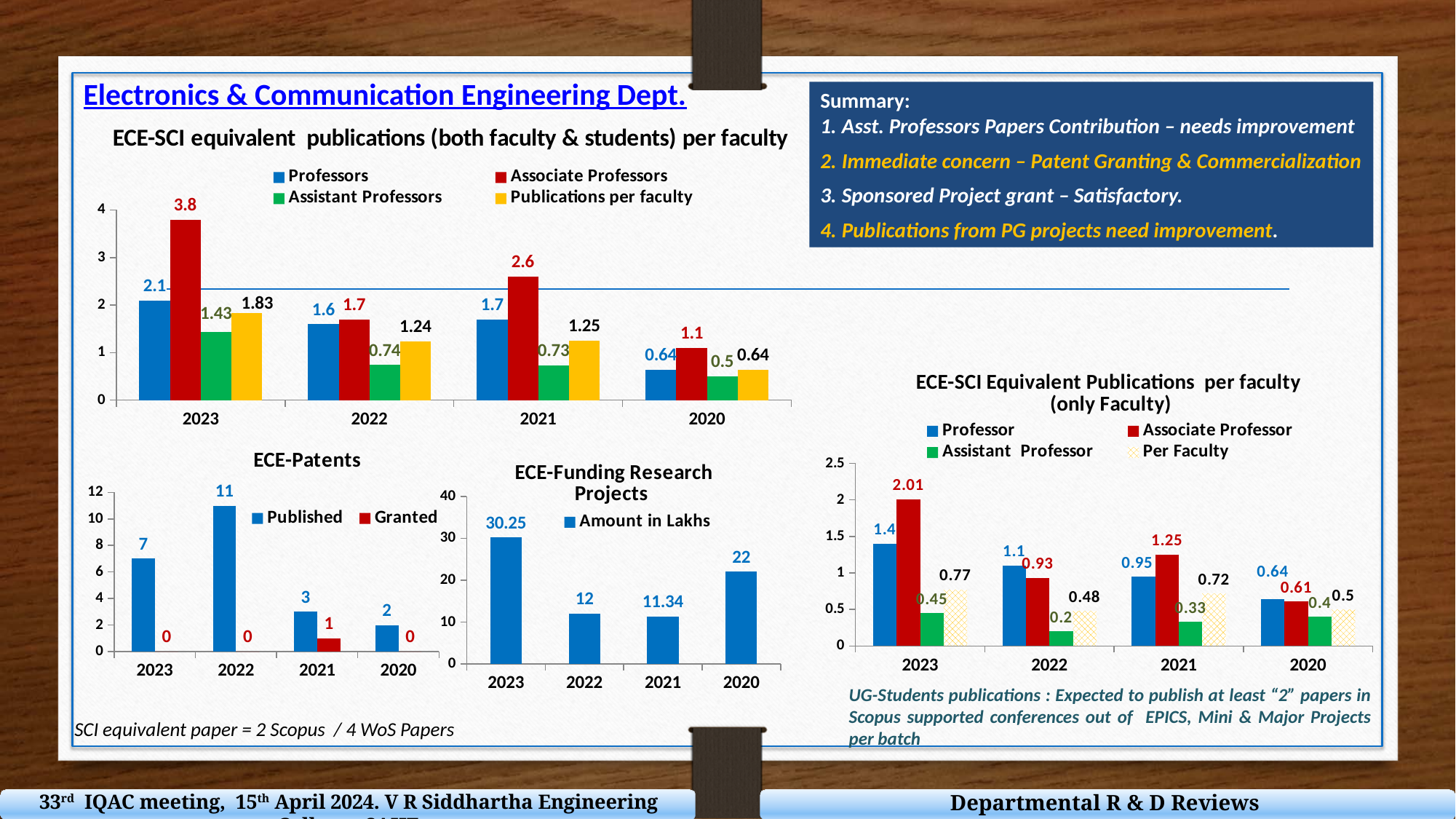
In the ECE-SCI equivalent publications (both faculty & students) per faculty chart, what is the Publications per faculty value for 2022? 1.24 In the ECE-Patents chart, which year has the highest number of Published patents? 2022 In the ECE-SCI Equivalent Publications per faculty (only Faculty) chart, what is the Associate Professor value for 2023? 2.01 What kind of chart is the ECE-Funding Research Projects chart? Bar chart In the ECE-SCI equivalent publications (both faculty & students) per faculty chart, how many series does the legend list? 4 In the ECE-Patents chart, what is the difference between Published patents in 2022 and 2023? 4 In the ECE-SCI equivalent publications (both faculty & students) per faculty chart, what is the difference between the Associate Professors and Professors values in 2021? 0.9 In the ECE-Patents chart, how many patents were Granted in 2021? 1 In the ECE-SCI Equivalent Publications per faculty (only Faculty) chart, which is larger in 2022: the Professor value or the Associate Professor value? Professor In the ECE-SCI equivalent publications (both faculty & students) per faculty chart, what is the value for Associate Professors in 2023? 3.8 In the ECE-Funding Research Projects chart, which year has the lowest Amount in Lakhs? 2021 In the ECE-Funding Research Projects chart, what is the Amount in Lakhs for 2020? 22